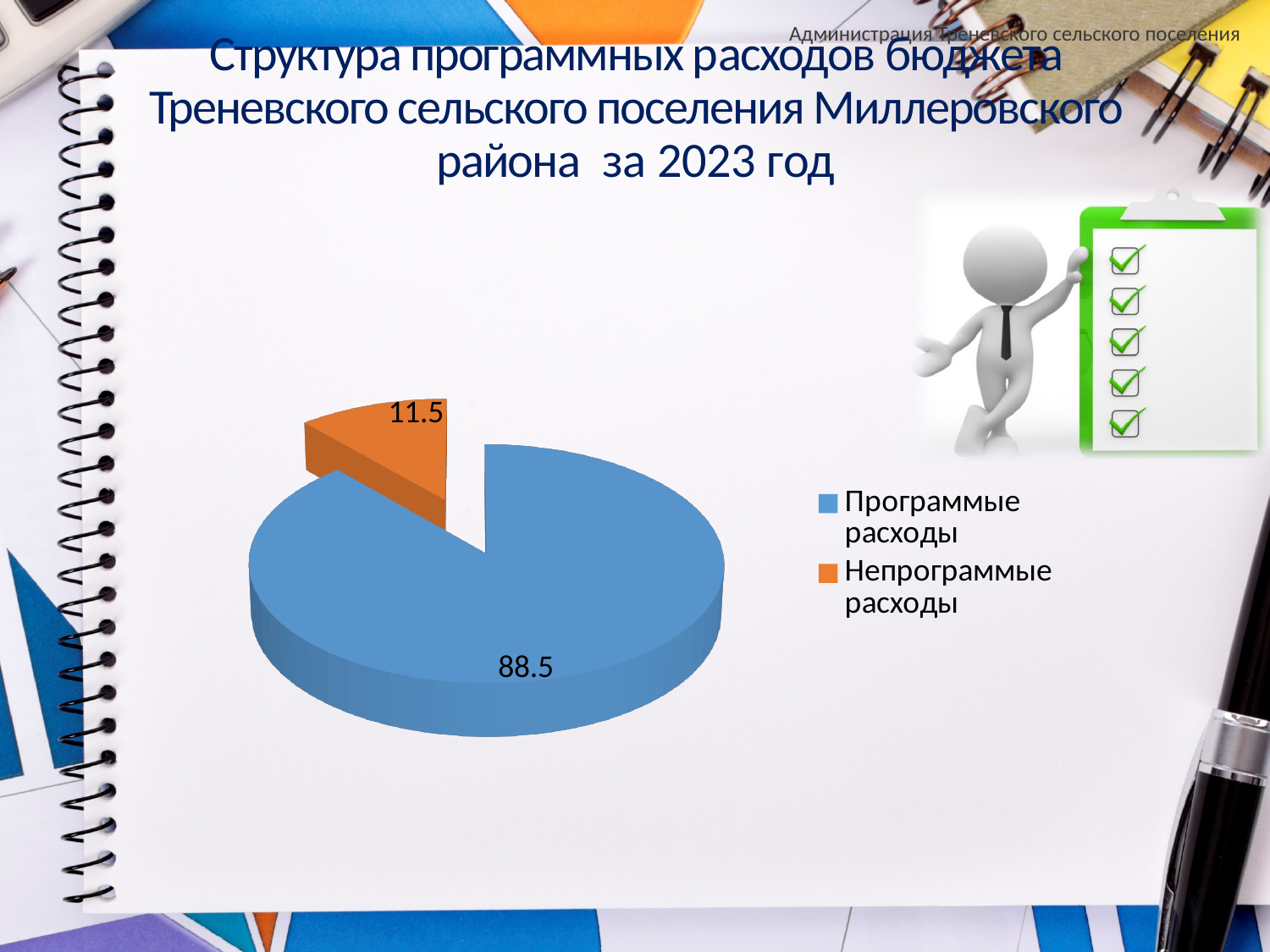
What colour is the slice for Непрограммые расходы? orange What is the value for Непрограммые расходы? 11.5 How many slices does the pie chart have? 2 Which category has the largest slice? Программые расходы What is the difference between the values for Программые расходы and Непрограммые расходы? 77 Which category has the smallest slice? Непрограммые расходы What kind of chart is shown on the slide? pie chart What is the value for Программые расходы? 88.5 What is the total of the two values shown on the pie chart? 100 How many entries does the legend list? 2 Which year does the chart title refer to? 2023 Which is larger, Программые расходы or Непрограммые расходы? Программые расходы